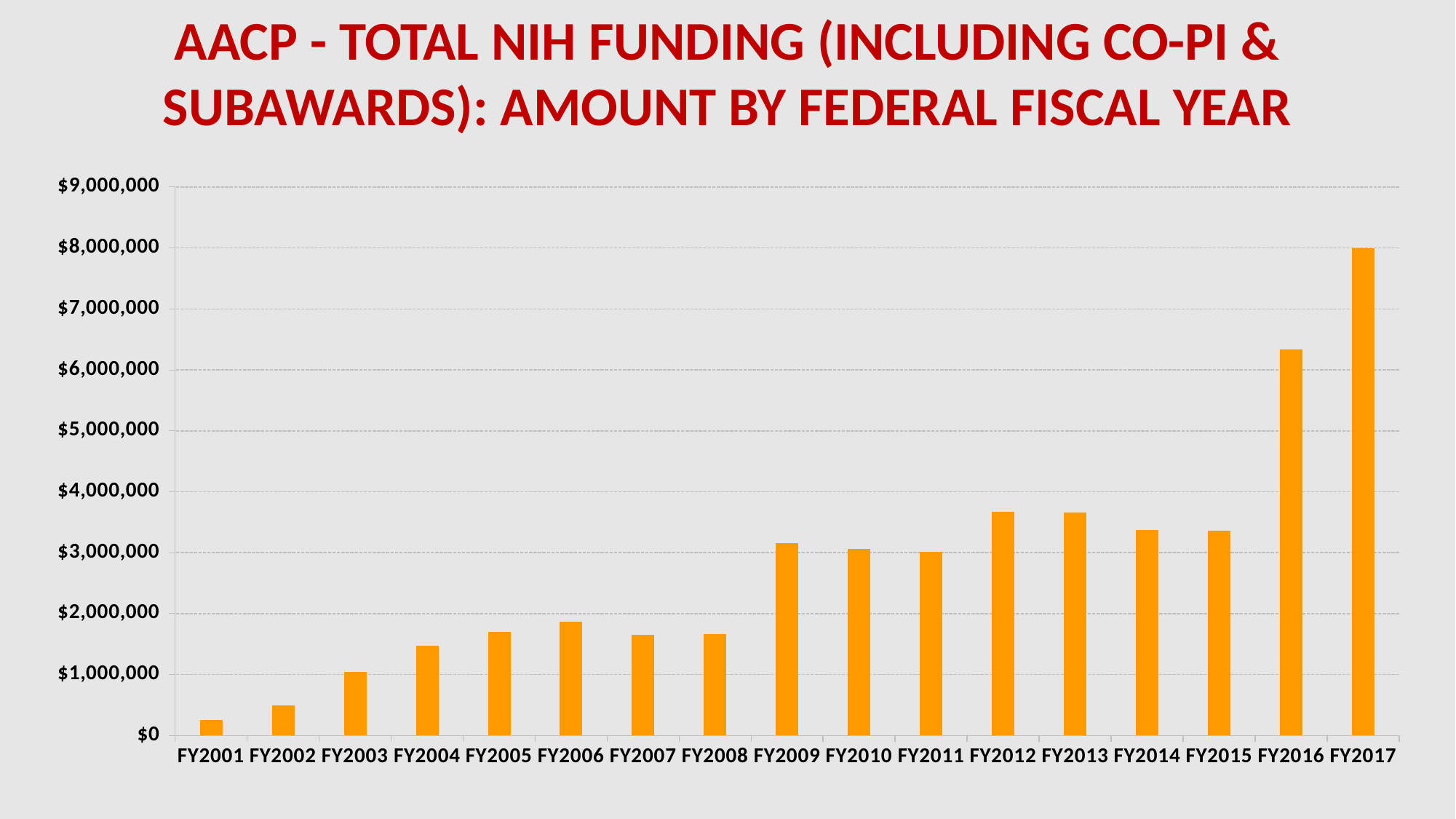
Is the value for FY2006 greater or less than $2,000,000? less Which fiscal year has the highest total NIH funding? FY2017 Which has higher funding, FY2003 or FY2005? FY2005 What kind of chart is shown on the slide? Bar chart Is the value for FY2017 greater or less than $7,000,000? greater Is the value for FY2016 greater or less than $6,000,000? greater Overall, does total NIH funding rise or fall from FY2001 to FY2017? Rise Which has higher funding, FY2016 or FY2009? FY2016 Which fiscal year has the lowest total NIH funding? FY2001 How many fiscal years are plotted on the chart? 17